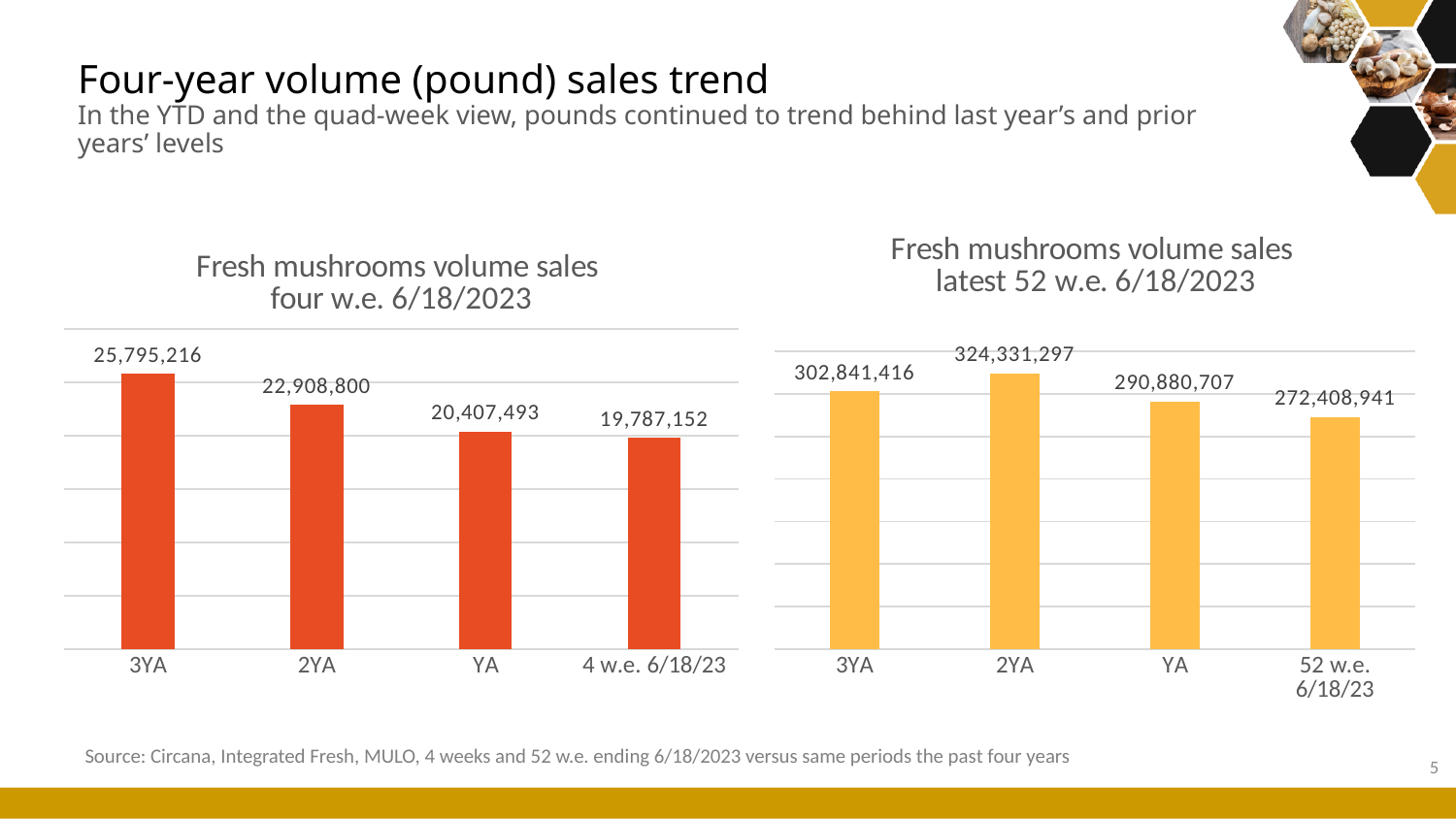
In the 'Fresh mushrooms volume sales latest 52 w.e. 6/18/2023' chart, what is the value for 52 w.e. 6/18/23? 272,408,941 In the 'Fresh mushrooms volume sales latest 52 w.e. 6/18/2023' chart, which is larger, the value for 3YA or the value for 2YA? 2YA In the 'Fresh mushrooms volume sales four w.e. 6/18/2023' chart, which category has the lowest value? 4 w.e. 6/18/23 In the 'Fresh mushrooms volume sales four w.e. 6/18/2023' chart, what is the value for 4 w.e. 6/18/23? 19,787,152 What kind of chart is the 'Fresh mushrooms volume sales four w.e. 6/18/2023' chart? Bar chart In the 'Fresh mushrooms volume sales latest 52 w.e. 6/18/2023' chart, what is the difference between the 2YA value and the YA value? 33,450,590 In the 'Fresh mushrooms volume sales latest 52 w.e. 6/18/2023' chart, which category has the highest value? 2YA In the 'Fresh mushrooms volume sales four w.e. 6/18/2023' chart, what is the value for 3YA? 25,795,216 In the 'Fresh mushrooms volume sales latest 52 w.e. 6/18/2023' chart, what is the value for YA? 290,880,707 In the 'Fresh mushrooms volume sales four w.e. 6/18/2023' chart, what is the difference between the 3YA value and the 4 w.e. 6/18/23 value? 6,008,064 How many categories are shown in the 'Fresh mushrooms volume sales four w.e. 6/18/2023' chart? 4 In the 'Fresh mushrooms volume sales four w.e. 6/18/2023' chart, do the values rise or fall from 3YA to 4 w.e. 6/18/23? Fall